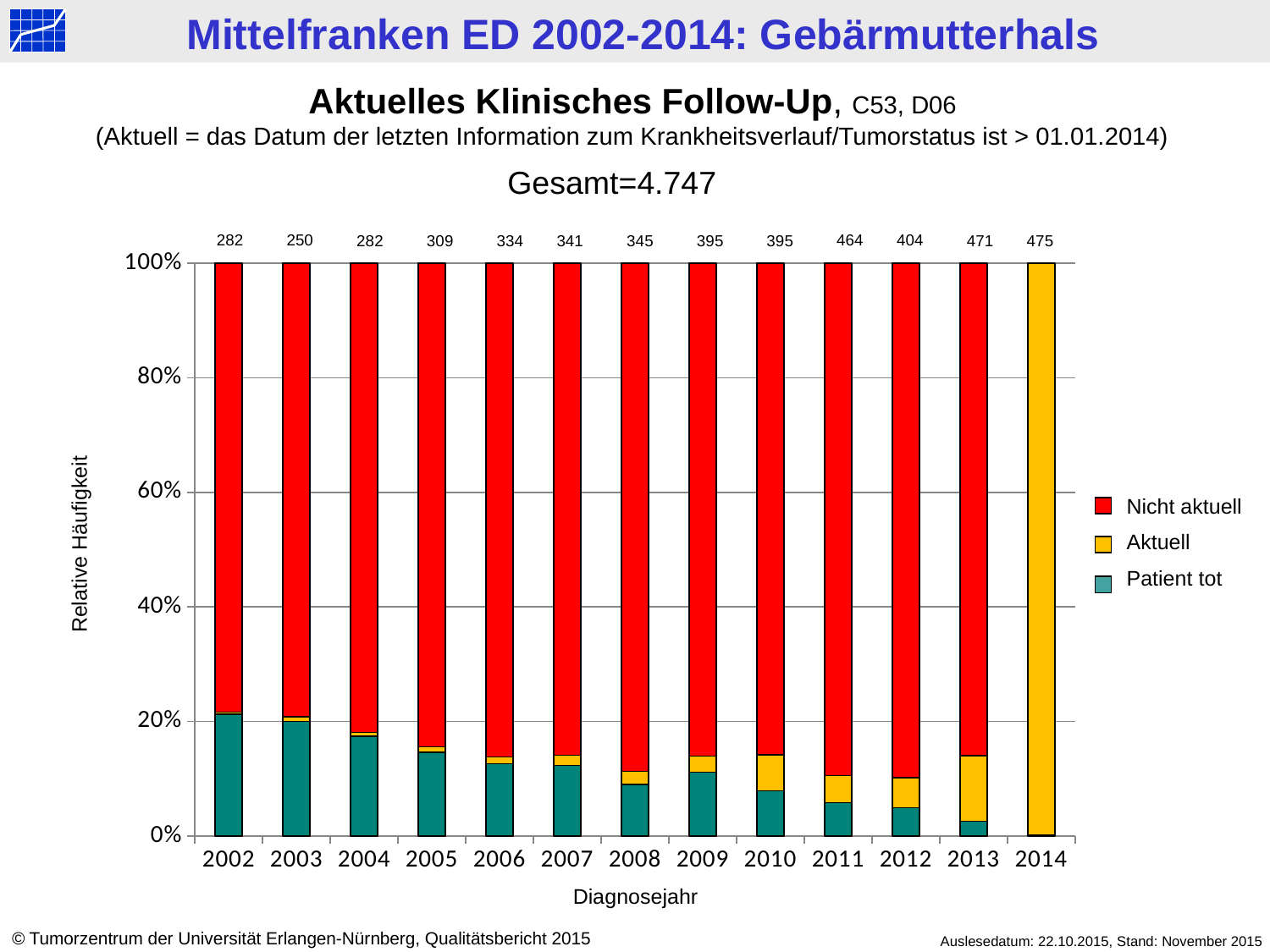
What kind of chart is shown on the slide? Stacked bar chart What is the number of cases shown above the bar for 2011? 464 Which diagnosis year has the lowest number of cases printed above its bar? 2003 Is the 'Patient tot' share for 2004 greater or less than 20%? less What is the difference between the case counts printed for 2014 and 2002? 193 How many series does the legend list? 3 Which year has the larger case count printed above its bar, 2011 or 2012? 2011 Which diagnosis year has the highest number of cases printed above its bar? 2014 What is the total number of cases (Gesamt) stated on the slide? 4.747 What is the number of cases shown above the bar for 2002? 282 Is the 'Nicht aktuell' share for 2008 greater or less than 80%? greater How many diagnosis years are shown on the x axis? 13